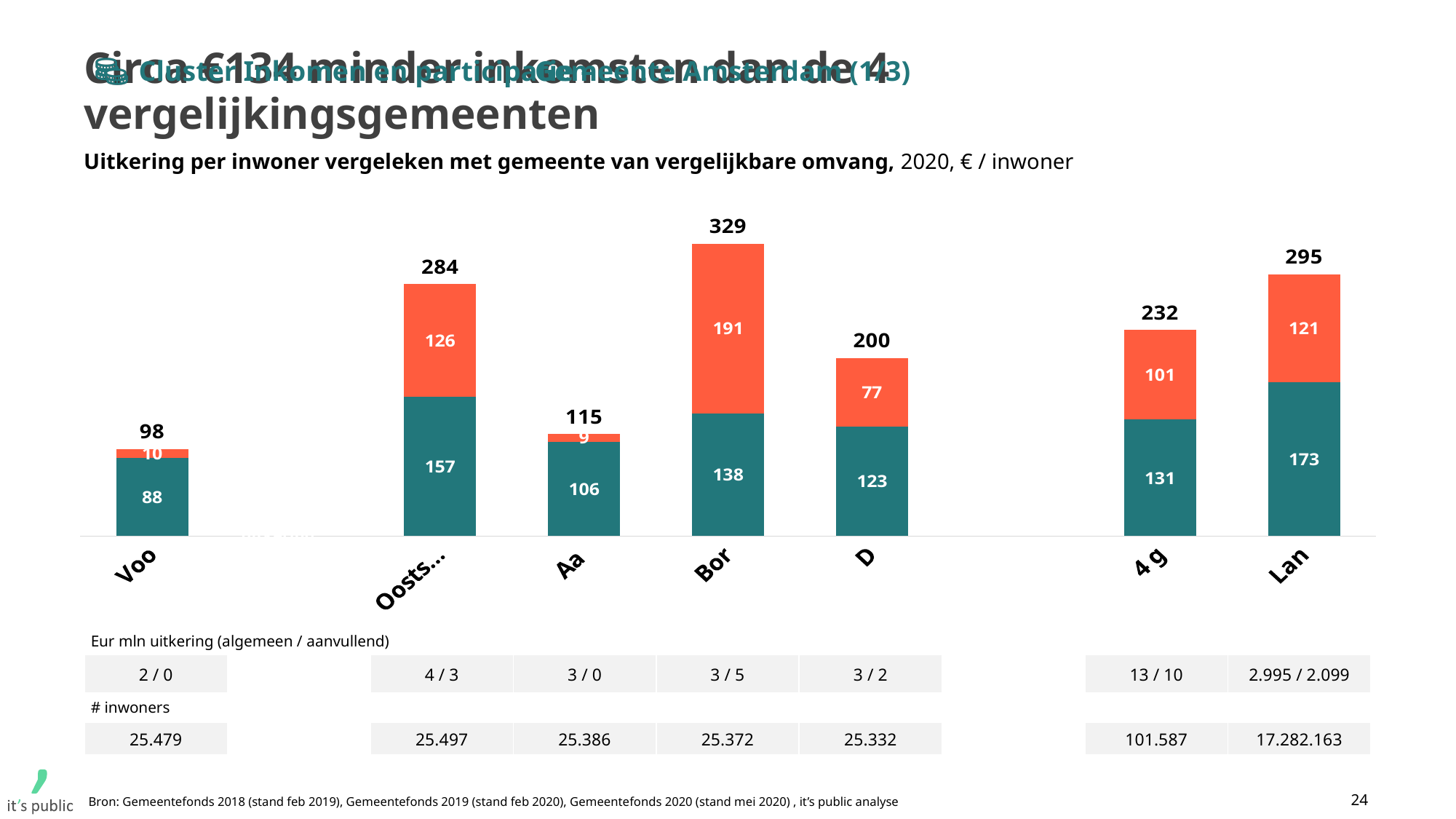
What is the difference between the teal segment and the orange segment of the bar for Oosts...? 31 What is the total value shown above the bar for Bor? 329 What is the difference between the total for Bor and the total for Voo? 231 What is the value of the teal (bottom) segment of the bar for Lan? 173 Which has a larger total, Oosts... or Lan? Lan What is the value of the orange (top) segment of the bar for Aa? 9 What year does the chart subtitle say the data is for? 2020 Which category has the highest total value? Bor What is the total value shown above the bar for 4 g? 232 What is the value of the orange (top) segment of the bar for D? 77 What kind of chart is shown on the slide? Stacked bar chart Which category has the lowest total value? Voo